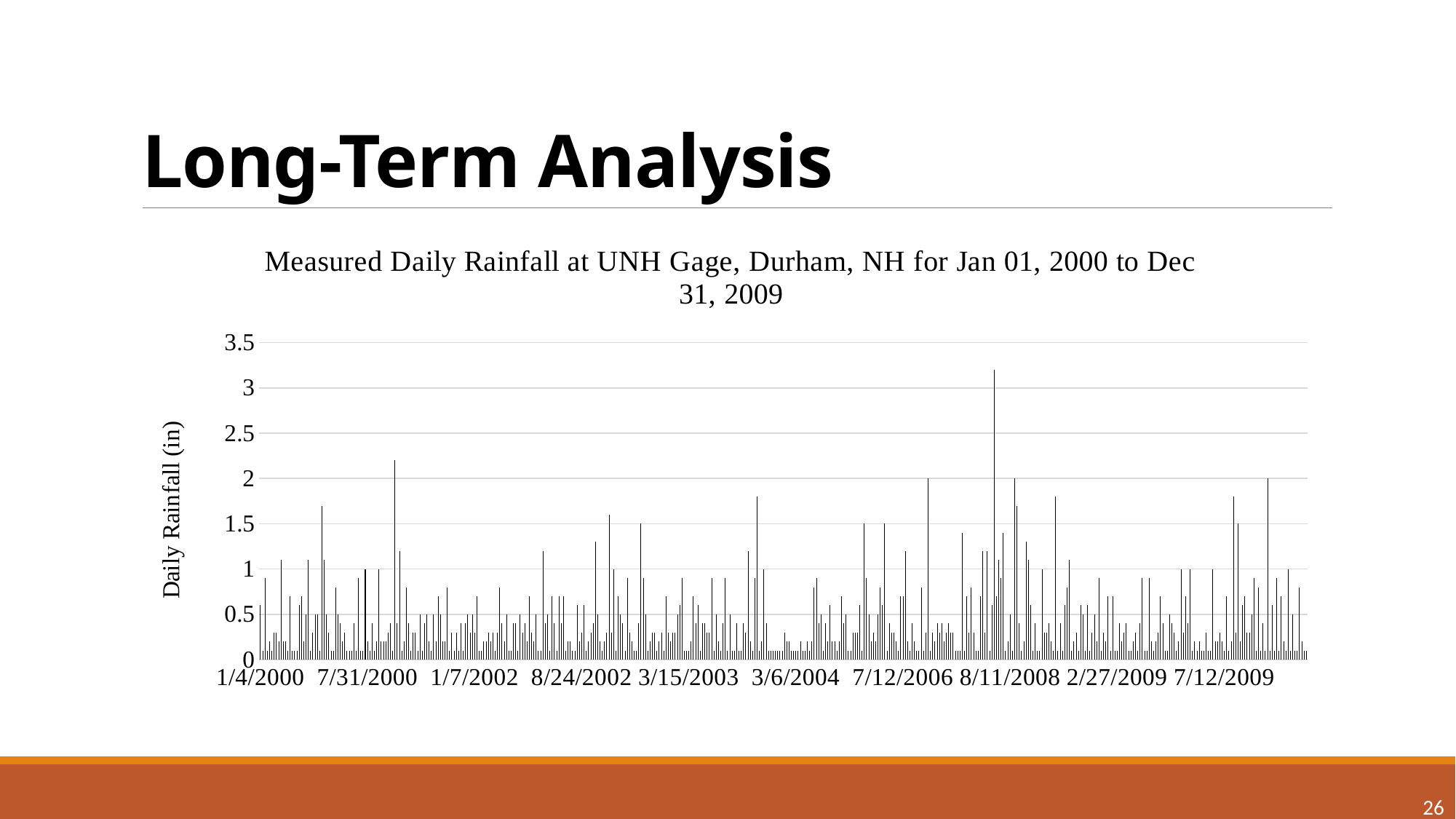
Is the tallest bar in the chart located before or after the 3/6/2004 label on the x axis? after Is the highest daily rainfall value in the chart greater or less than 3? greater Is the tallest bar near the 7/31/2000 label greater or less than 2? greater Is the highest daily rainfall value in the chart greater or less than 3.5? less Near which x-axis date label does the tallest bar in the chart occur? 8/11/2008 What is the label on the vertical axis of the chart? Daily Rainfall (in) What is the title of the chart? Measured Daily Rainfall at UNH Gage, Durham, NH for Jan 01, 2000 to Dec 31, 2009 What kind of chart is shown on the slide? bar chart How many date labels are shown along the x axis of the chart? 10